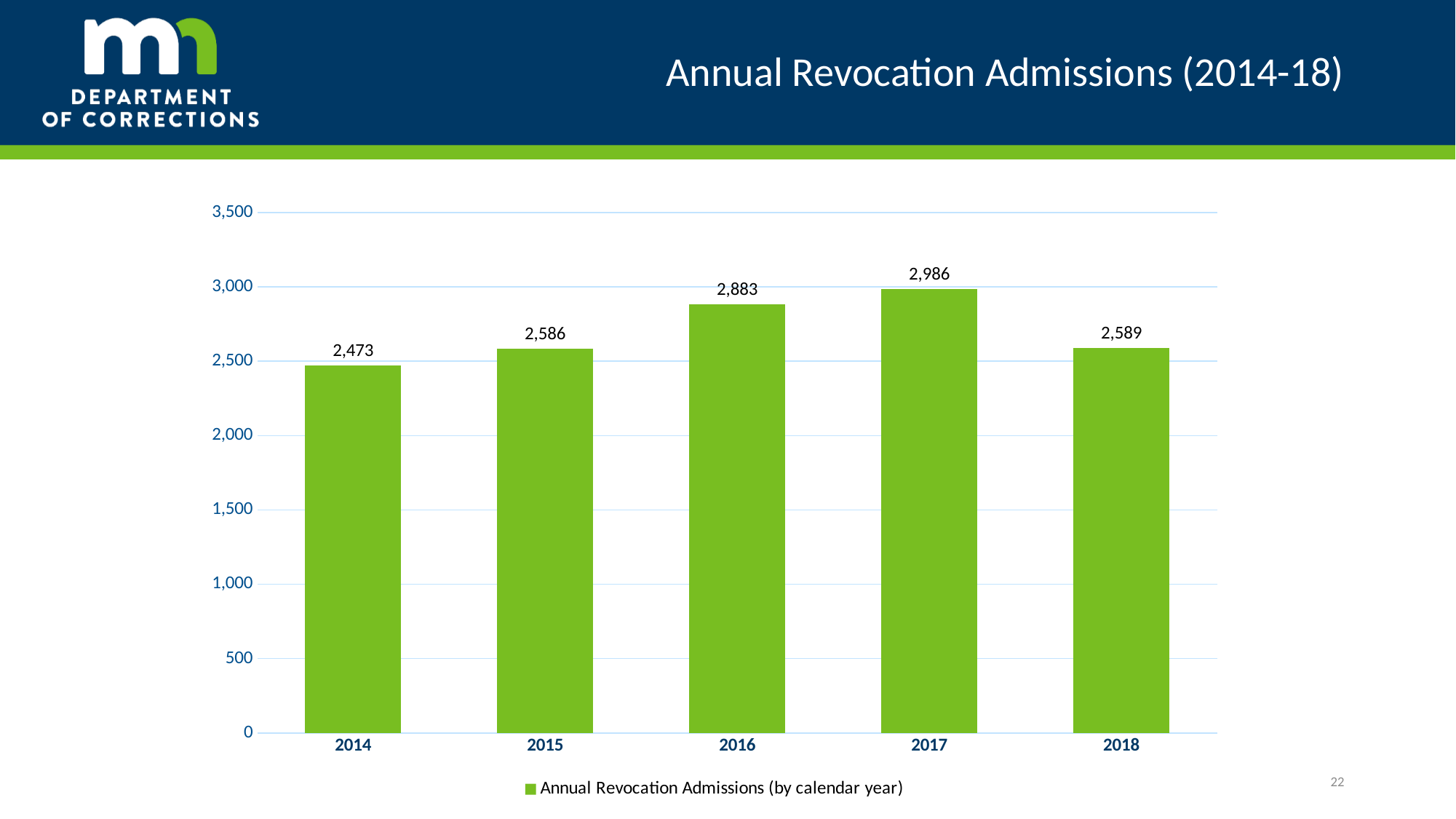
How many years are shown on the x axis? 5 What is the value for 2014? 2,473 What is the value for 2017? 2,986 Which year has the highest annual revocation admissions? 2017 What is the difference between the values for 2017 and 2016? 103 What is the legend entry for the series shown? Annual Revocation Admissions (by calendar year) Which is larger, the value for 2016 or the value for 2015? 2016 What is the value for 2018? 2,589 Which year has the lowest annual revocation admissions? 2014 What kind of chart is shown on the slide? bar chart Is the value for 2017 greater or less than 2,500? greater What is the difference between the values for 2018 and 2014? 116